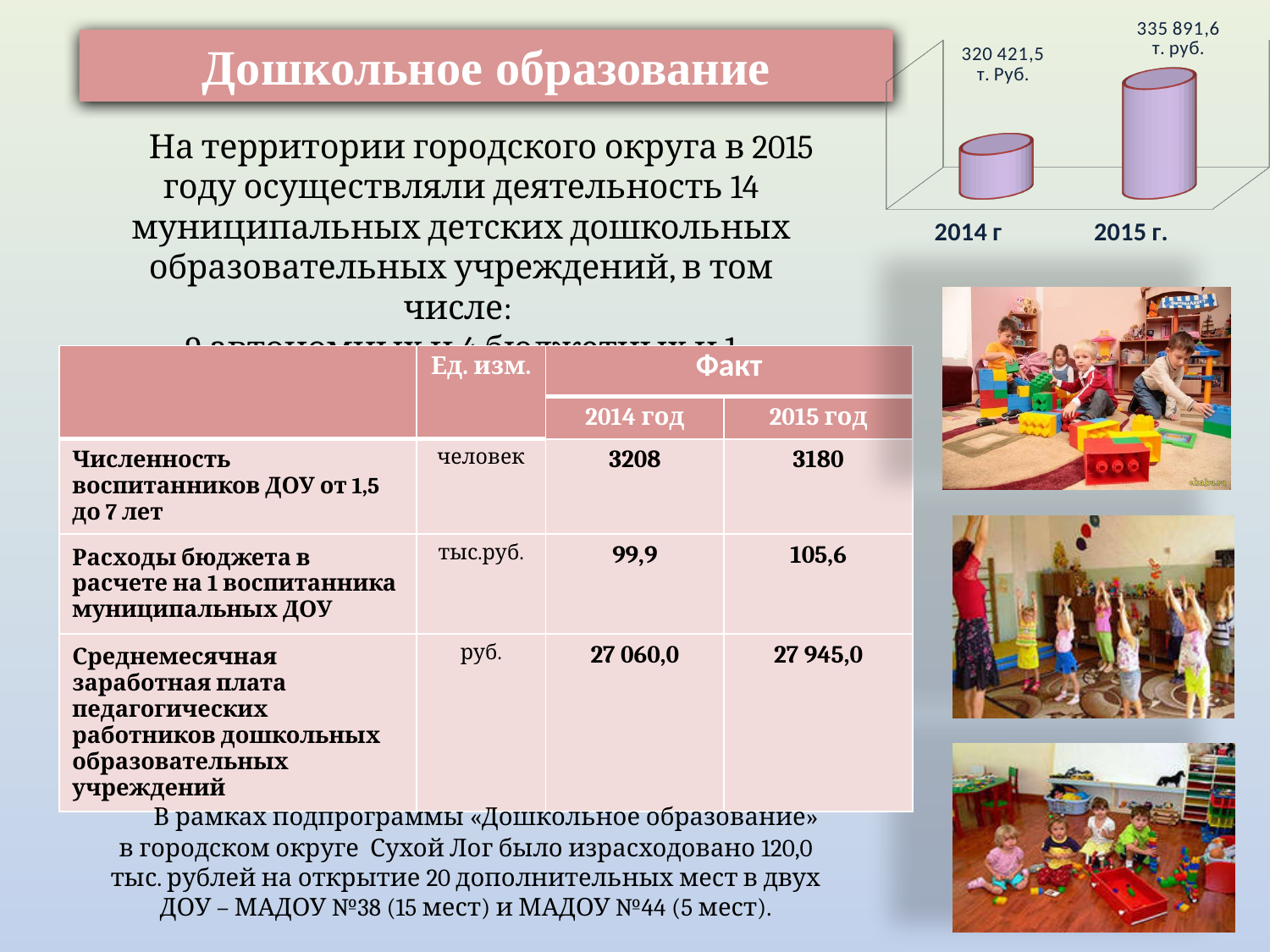
Which year has the higher value in the chart? 2015 г. By how much does the 2015 г. value exceed the 2014 г value in the chart? 15 470,1 What colour are the bars in the chart? purple What is the value shown for 2014 г in the chart? 320 421,5 т. Руб. Do the values in the chart rise or fall from 2014 г to 2015 г.? rise What is the value shown for 2015 г. in the chart? 335 891,6 т. руб. Which year has the lower value in the chart? 2014 г Is the value for 2015 г. larger or smaller than the value for 2014 г? larger How many categories (years) are plotted in the chart? 2 What kind of chart is shown in the top right of the slide? bar chart